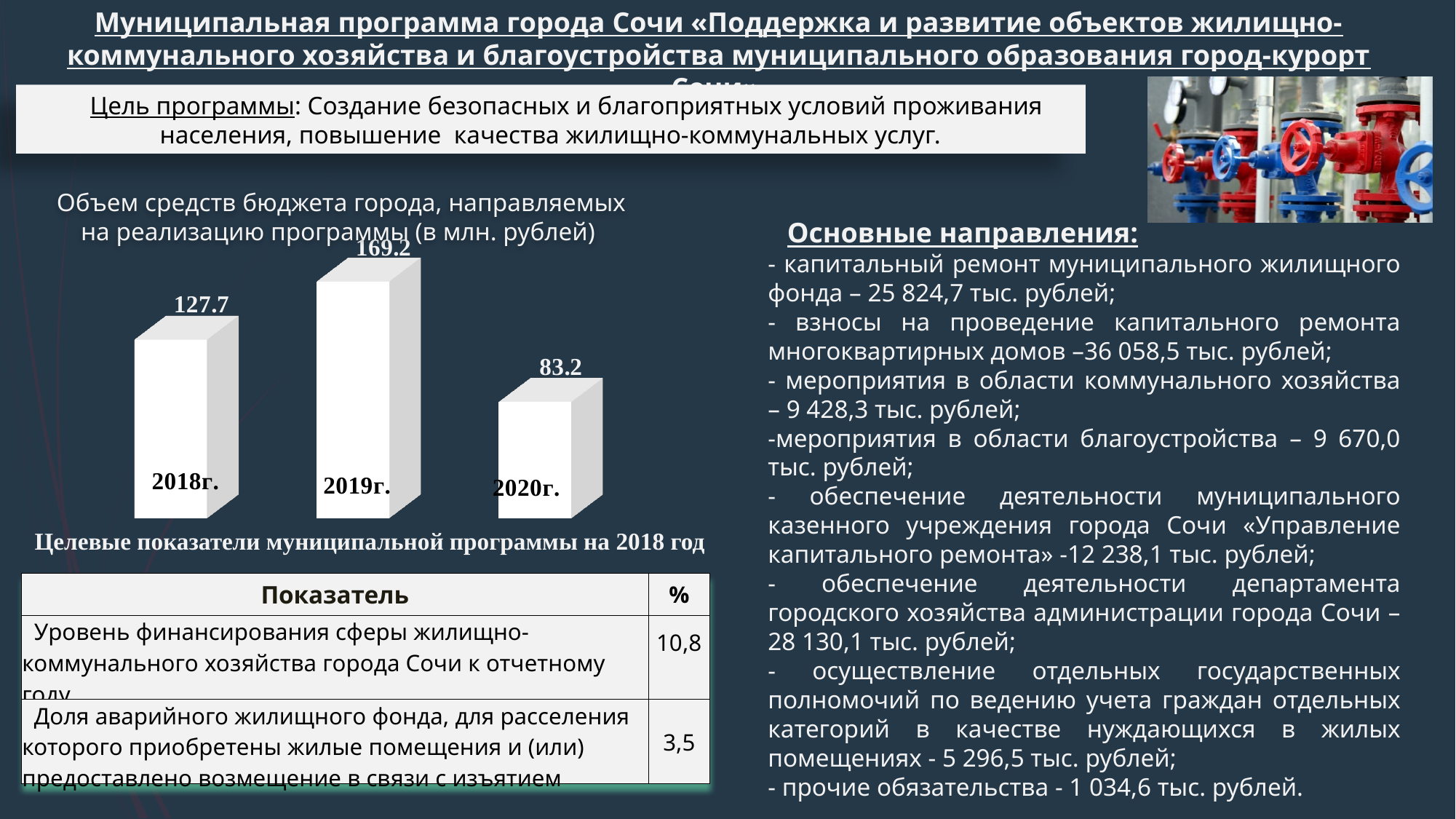
Which is larger, the budget volume for 2018г. or for 2020г.? 2018г. Which year has the lowest budget volume in the chart? 2020г. Which year has the highest budget volume in the chart? 2019г. What is the difference between the budget volumes for 2019г. and 2020г.? 86.0 In what units are the values in the chart expressed, according to its title? млн. рублей What is the budget volume for 2020г. in the chart? 83.2 What is the difference between the budget volumes for 2019г. and 2018г.? 41.5 What is the budget volume for 2019г. in the chart? 169.2 What kind of chart is shown on the slide? bar chart Does the budget volume rise or fall from 2019г. to 2020г.? fall What is the budget volume for 2018г. in the chart? 127.7 How many years are shown in the chart? 3